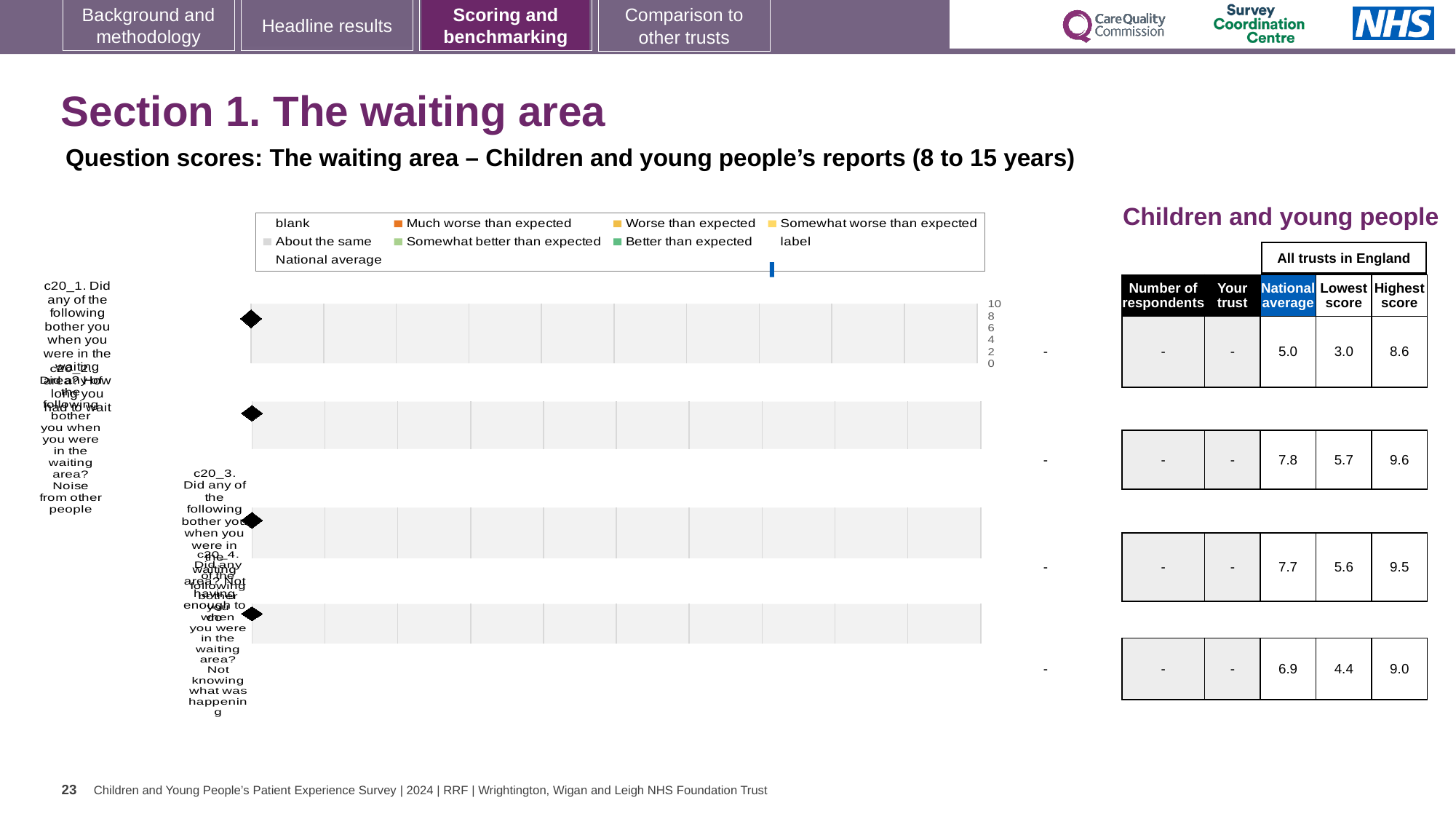
Which legend entry is shown with a dark green marker? Better than expected What kind of chart is shown on the slide? bar chart In the table beside the chart, which row has the lowest national average score? c20_1 (5.0) In the table beside the chart, is the national average for c20_1 greater or less than 6? less In the table beside the chart, which row has the highest national average score? c20_2 (7.8) In the table beside the chart, what is the national average score for c20_1 (the first row)? 5.0 In the table beside the chart, what is the highest score for c20_2 (the second row)? 9.6 What is the subtitle above the chart describing the question scores? Question scores: The waiting area – Children and young people’s reports (8 to 15 years) In the table beside the chart, what is the lowest score for c20_4 (the fourth row)? 4.4 In the table beside the chart, is the national average for c20_3 or c20_4 larger? c20_3 How many question categories (bars) are plotted in the chart? 4 In the table beside the chart, what is the difference between the highest score and the lowest score for c20_3 (the third row)? 3.9